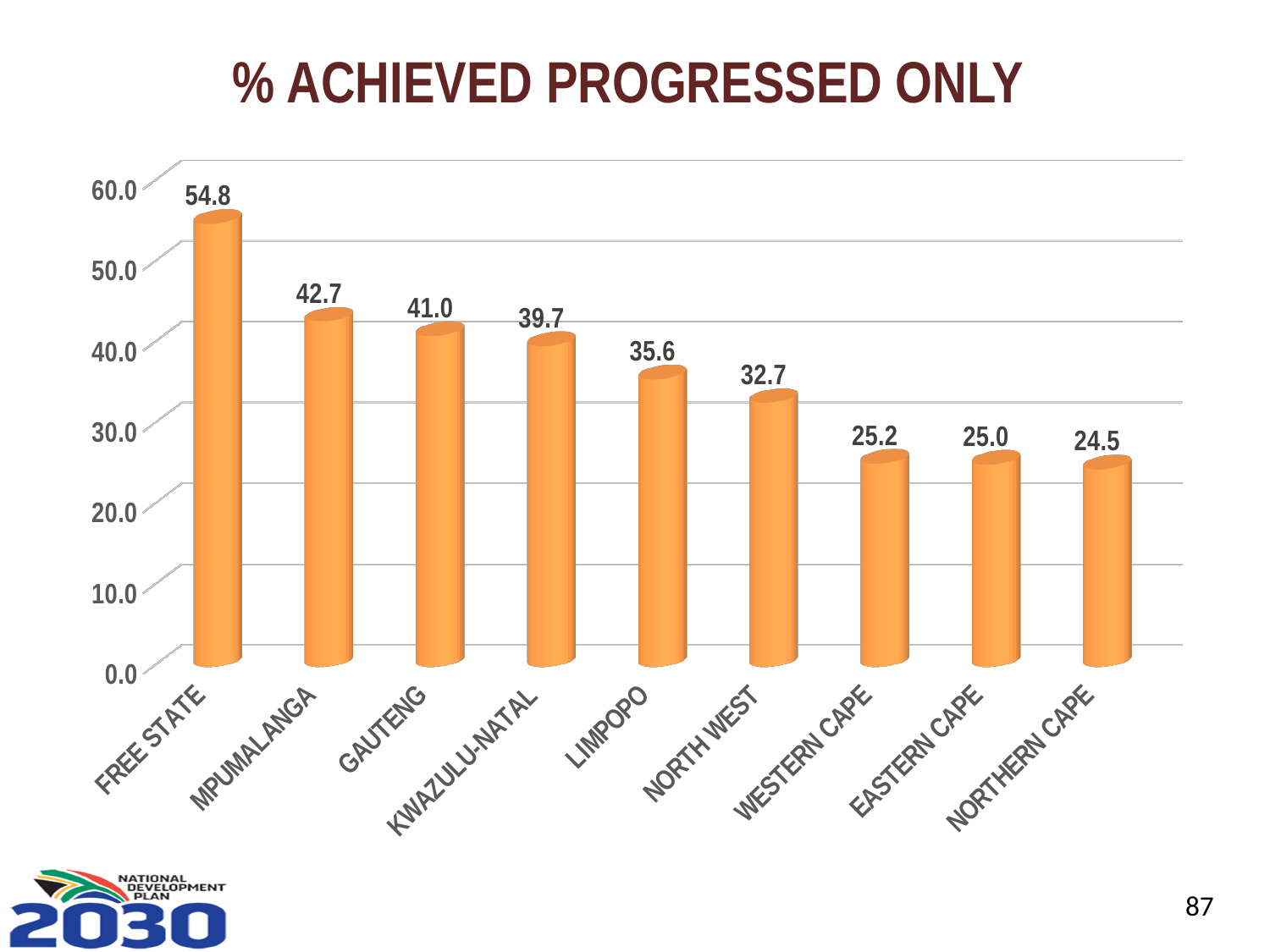
Which province has the lowest value? Northern Cape Is the value for North West greater or less than 30.0? greater What is the title of the chart? % ACHIEVED PROGRESSED ONLY What is the difference between the values for Free State and Mpumalanga? 12.1 What is the value for Northern Cape? 24.5 What is the value for Limpopo? 35.6 What is the difference between the values for Gauteng and North West? 8.3 Which is larger, the value for KwaZulu-Natal or the value for Limpopo? KwaZulu-Natal What kind of chart is shown on the slide? Bar chart What is the value for Free State? 54.8 Which province has the highest value? Free State How many provinces are shown on the chart? 9